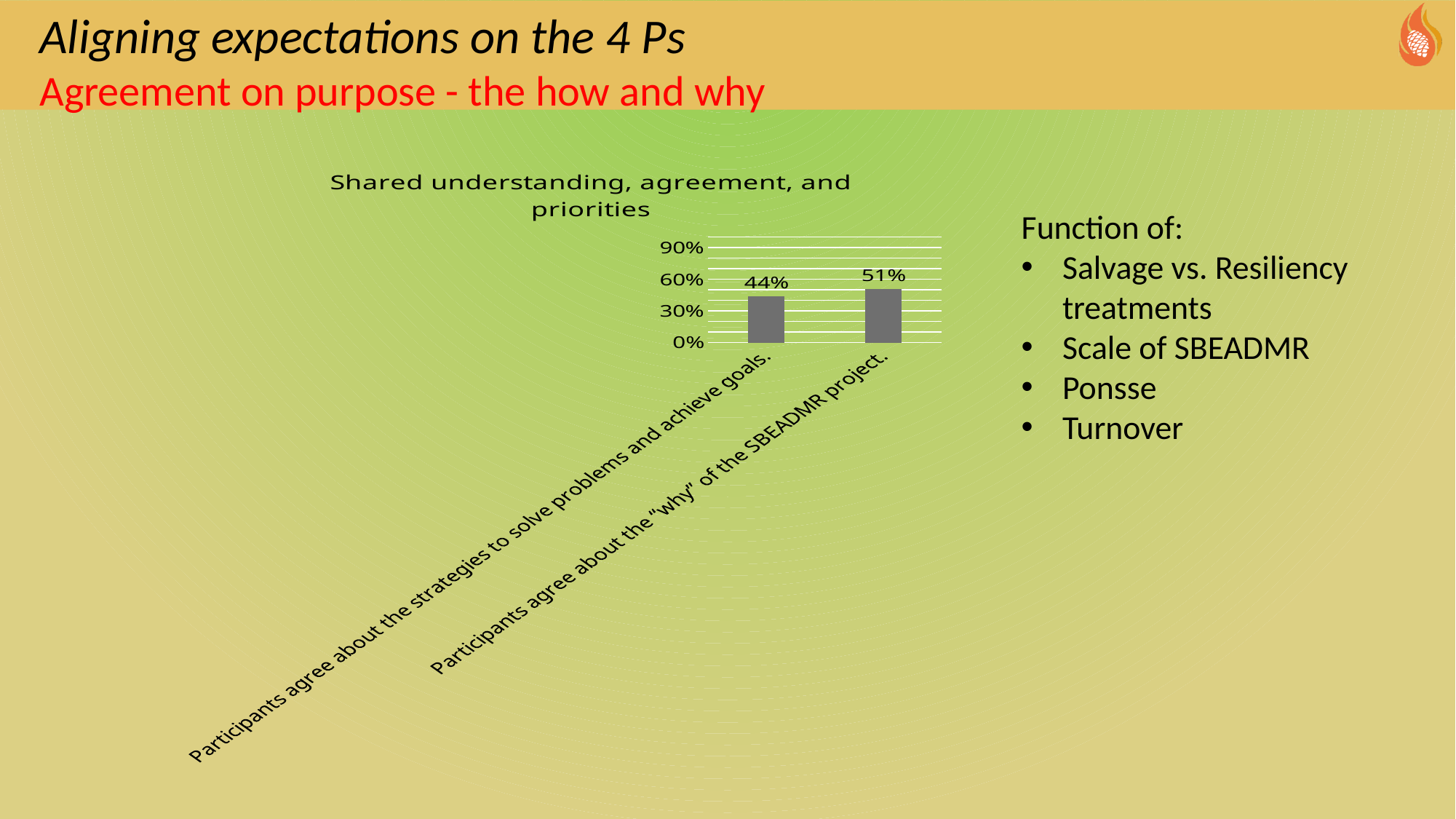
How many categories are shown in the chart? 2 Which category has the highest value? Participants agree about the "why" of the SBEADMR project. What is the value for "Participants agree about the "why" of the SBEADMR project."? 51% Is the value for "Participants agree about the "why" of the SBEADMR project." greater or less than 30%? greater What is the title of the chart? Shared understanding, agreement, and priorities Is the value for "Participants agree about the strategies to solve problems and achieve goals." greater or less than 60%? less Which category has the lowest value? Participants agree about the strategies to solve problems and achieve goals. What is the difference between the value for agreement about the "why" of the SBEADMR project and the value for agreement about the strategies to solve problems and achieve goals? 7% What is the highest value shown on the chart's vertical axis? 90% What kind of chart is shown on the slide? bar chart What is the value for "Participants agree about the strategies to solve problems and achieve goals."? 44% Which is larger: the value for agreement about the strategies to solve problems and achieve goals, or the value for agreement about the "why" of the SBEADMR project? Participants agree about the "why" of the SBEADMR project.